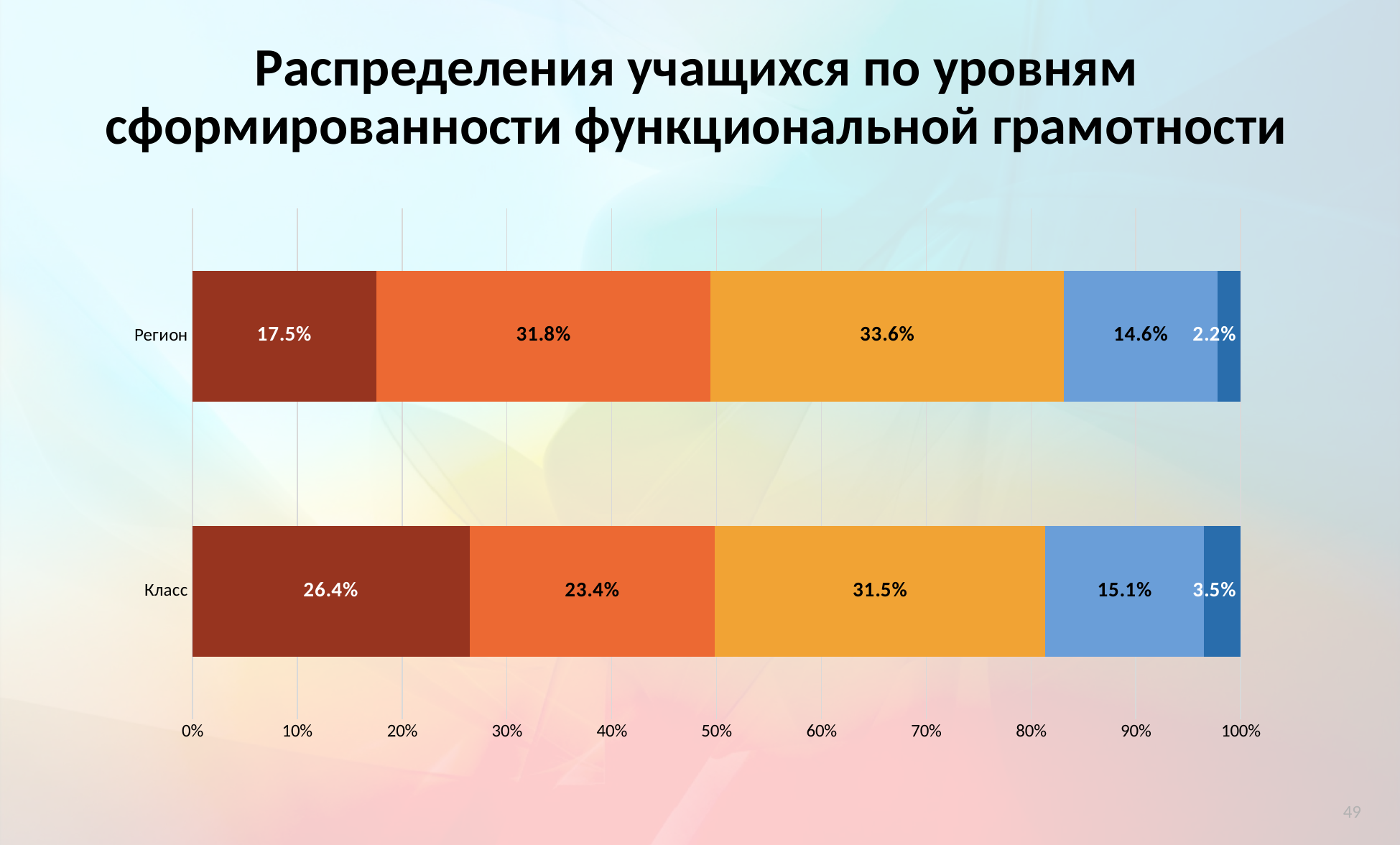
How many segments make up each bar in the chart? 5 What is the value of the third (amber) segment of the Регион bar? 33.6% What kind of chart is shown on the slide? Stacked bar chart Which segment of the Регион bar has the largest value? The third (amber) segment, 33.6% What is the value of the last (dark blue) segment of the Класс bar? 3.5% Is the light blue segment larger for Регион or for Класс? Класс What is the title of the slide? Распределения учащихся по уровням сформированности функциональной грамотности What is the value of the second (orange) segment of the Класс bar? 23.4% By how many percentage points does the dark red segment of Класс exceed the dark red segment of Регион? 8.9 percentage points How many categories (bars) does the chart show? 2 Which segment of the Класс bar has the smallest value? The last (dark blue) segment, 3.5% What is the value of the first (dark red) segment of the Регион bar? 17.5%